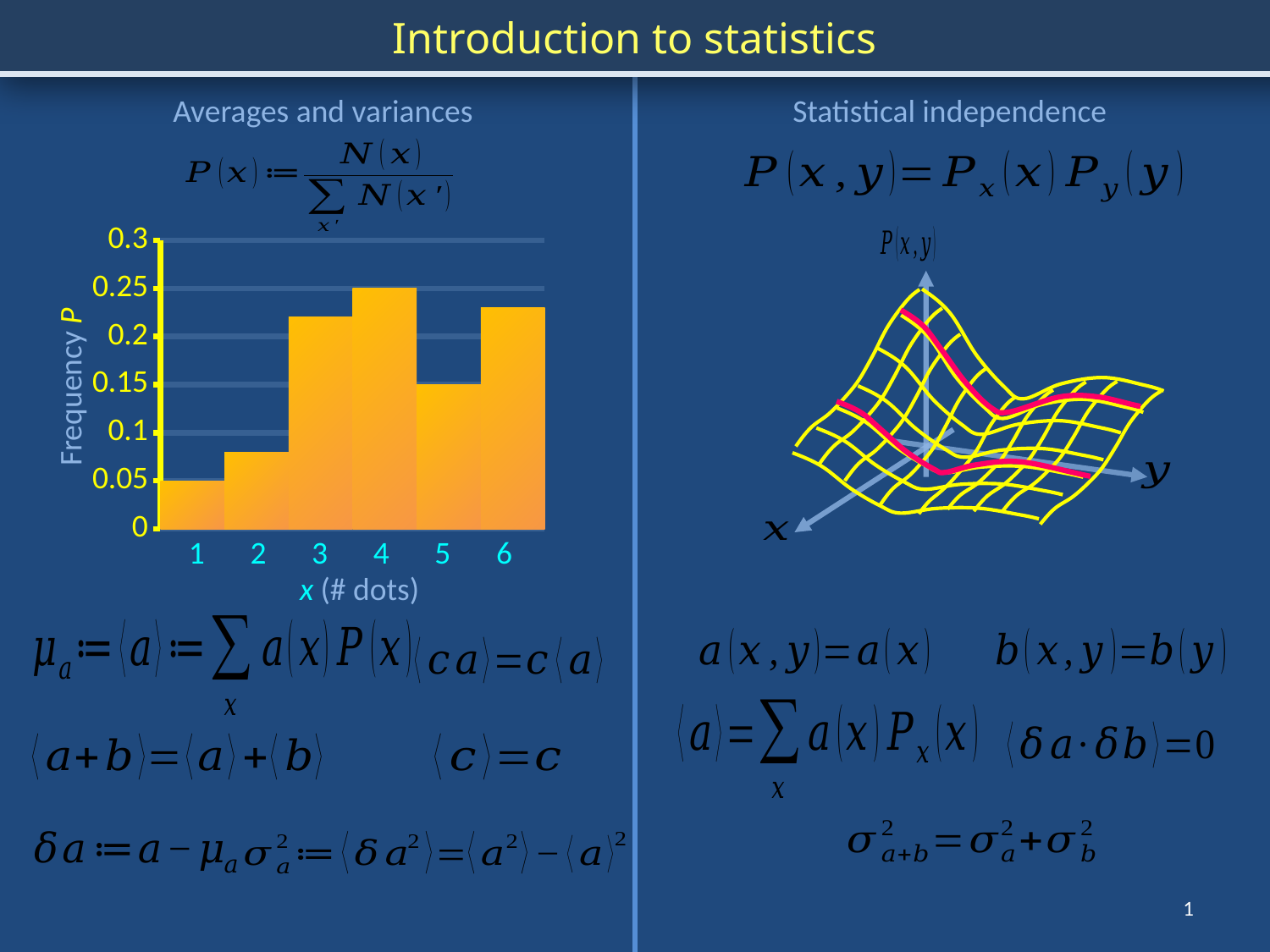
Which x value has the highest frequency P in the bar chart? 4 Is the frequency P for x = 2 greater or less than 0.1? less What is the frequency P for x = 4 in the bar chart? 0.25 How many x categories (# dots) are shown in the bar chart? 6 What is the label of the horizontal axis of the bar chart? x (# dots) Which x value has the lowest frequency P in the bar chart? 1 What is the frequency P for x = 5 in the bar chart? 0.15 What kind of chart is shown on the left side of the slide? bar chart What is the frequency P for x = 1 in the bar chart? 0.05 Is the frequency P for x = 3 greater or less than 0.2? greater What is the difference between the frequency P for x = 4 and x = 5? 0.1 Which has a larger frequency P, x = 3 or x = 5? 3